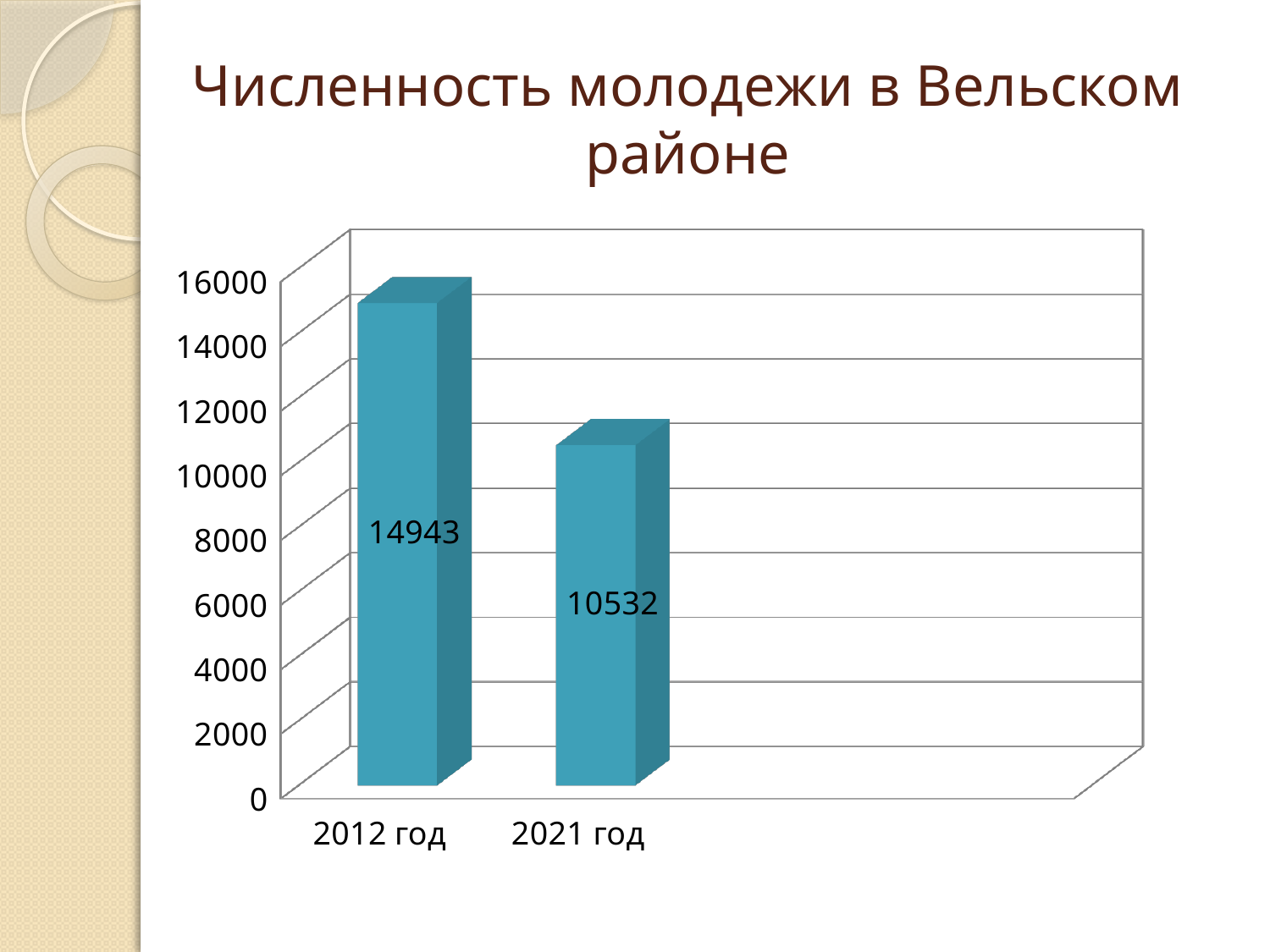
Is the value for 2012 год greater or less than 14000? greater Which category has the highest value? 2012 год What is the difference between the values for 2012 год and 2021 год? 4411 What is the value for 2021 год? 10532 Which is larger, the value for 2012 год or the value for 2021 год? 2012 год Is the value for 2021 год greater or less than 12000? less Which category has the lowest value? 2021 год What is the value for 2012 год? 14943 How many categories are shown on the x axis? 2 What is the title of the slide? Численность молодежи в Вельском районе What kind of chart is shown on the slide? bar chart Do the values rise or fall from 2012 год to 2021 год? fall